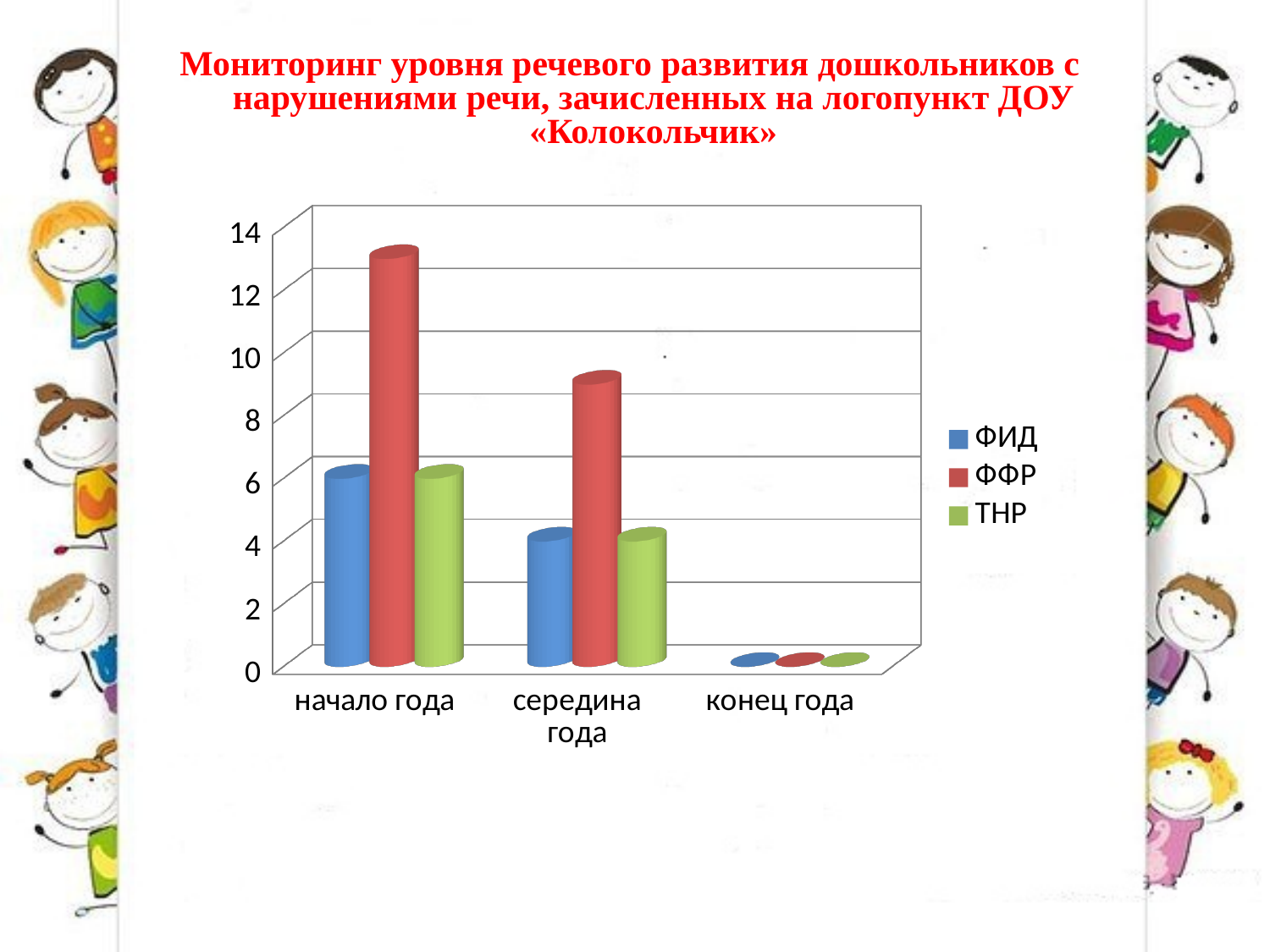
Is the value of ФФР for начало года greater or less than 10? greater What colour represents the ФФР series in the legend? red How many categories are shown on the x axis of the chart? 3 What kind of chart is shown on the slide? bar chart Which series has the highest value for начало года? ФФР How many series does the chart's legend list? 3 Is the value of ТНР for середина года greater or less than 6? less Which series has the highest value for середина года? ФФР Is the value of ФФР for середина года greater or less than 6? greater Which is larger for начало года: ФФР or ФИД? ФФР Do the values of ФФР rise or fall from начало года to конец года? fall